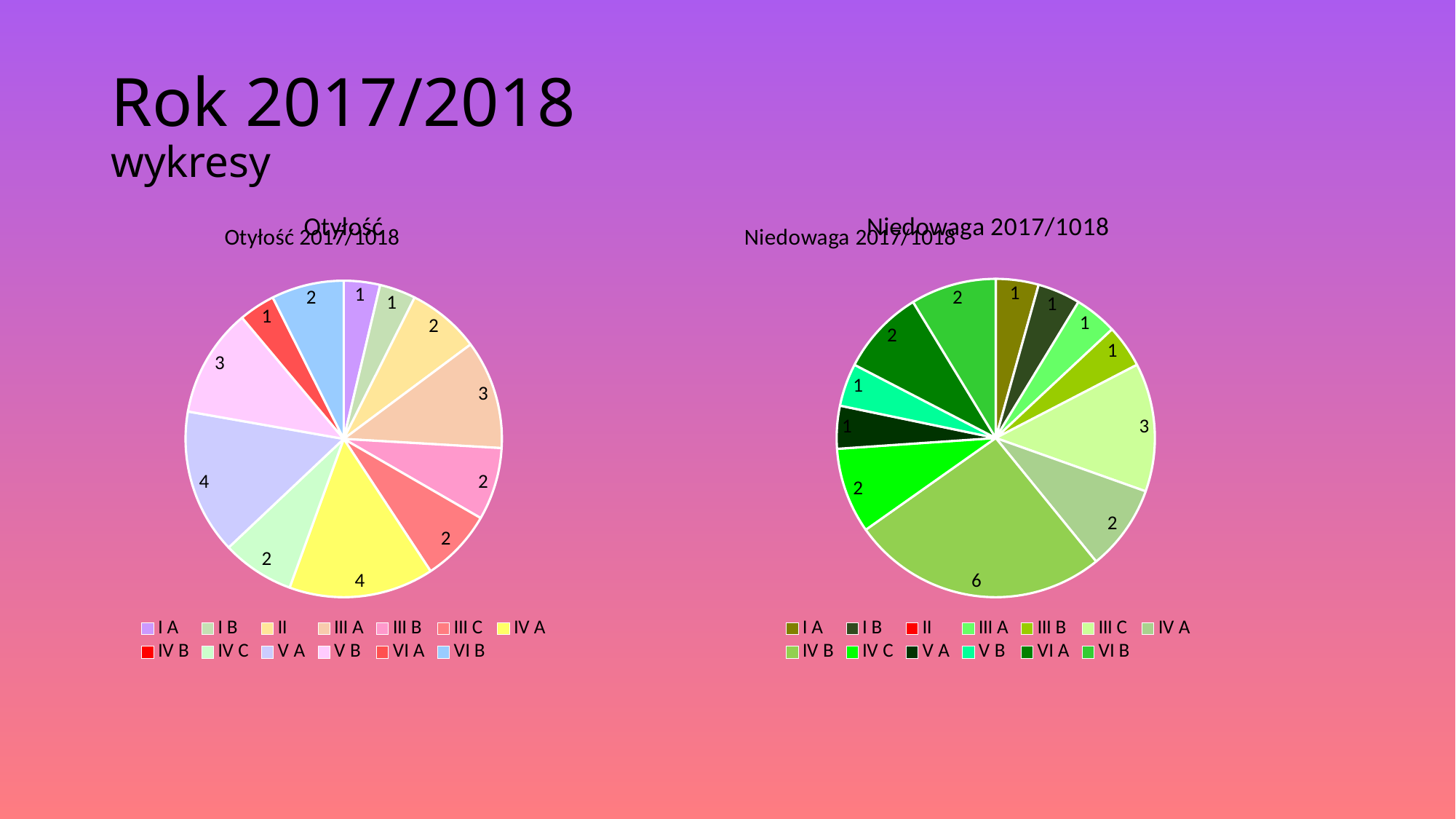
In the 'Niedowaga 2017/1018' chart on the right, which is larger, the value for IV B or the value for IV C? IV B In the 'Otyłość 2017/1018' chart on the left, what is the value for IV A (yellow slice)? 4 How many slices are drawn in the 'Niedowaga 2017/1018' pie chart on the right? 12 In the 'Niedowaga 2017/1018' chart on the right, what is the difference between the values for IV B and III C? 3 What type of chart is the 'Otyłość 2017/1018' chart on the left? pie chart In the 'Otyłość 2017/1018' chart on the left, which is larger, the value for IV A or the value for II? IV A How many entries does the legend of the 'Otyłość 2017/1018' chart on the left list? 13 In the 'Otyłość 2017/1018' chart on the left, what is the value for III A? 3 In the 'Niedowaga 2017/1018' chart on the right, what is the value for III C? 3 In the 'Niedowaga 2017/1018' chart on the right, which category has the largest slice? IV B In the 'Niedowaga 2017/1018' chart on the right, what is the value of the largest slice? 6 What is the title of the pie chart on the right of the slide? Niedowaga 2017/1018